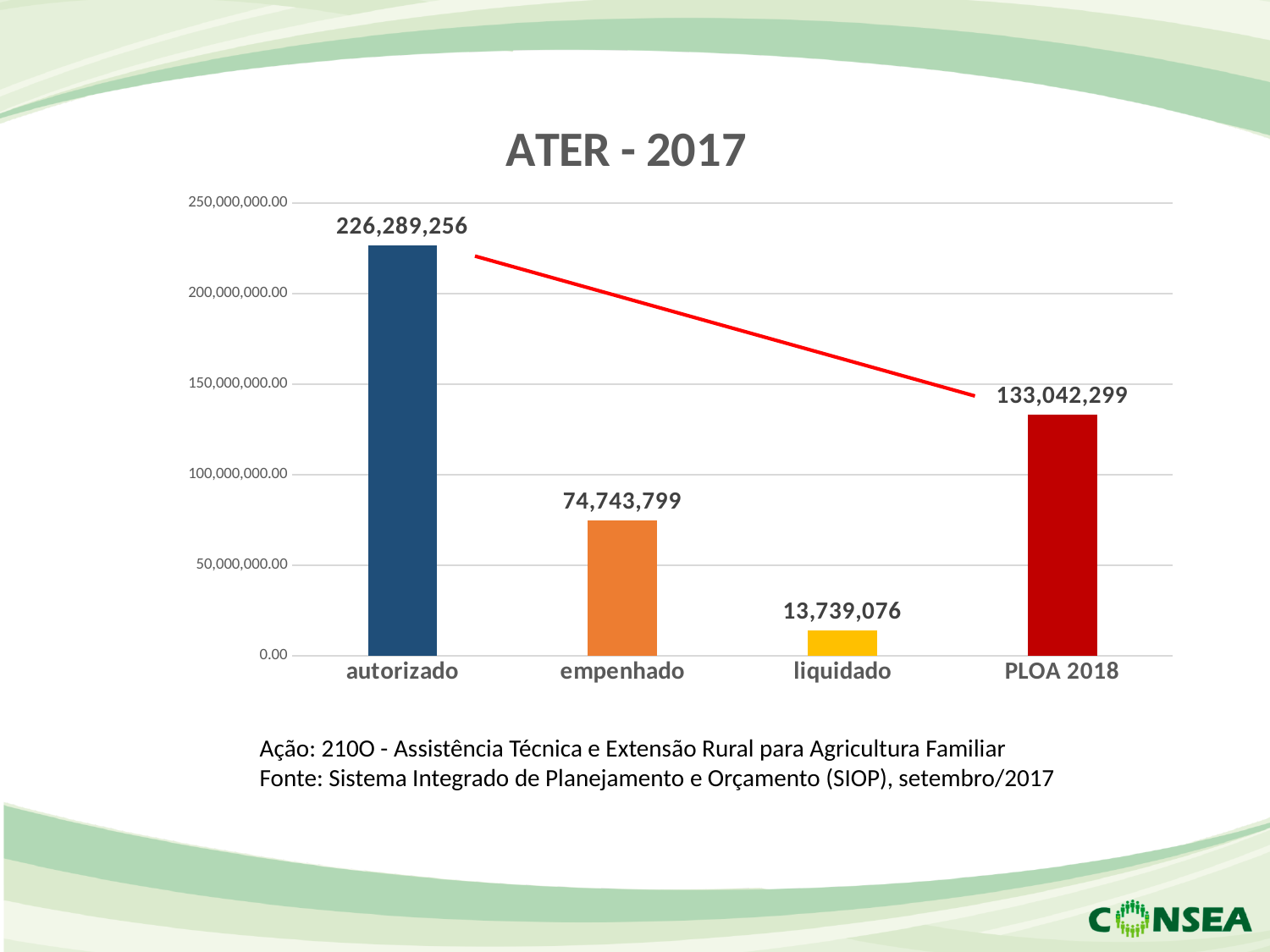
What is the value for PLOA 2018? 133,042,299 What is the difference between the values for empenhado and liquidado? 61,004,723 Which category has the lowest value? liquidado What is the title of the chart? ATER - 2017 What is the value for empenhado? 74,743,799 Which category has the highest value? autorizado How many categories are shown on the x axis? 4 What kind of chart is shown on the slide? bar chart What is the value for autorizado? 226,289,256 What is the value for liquidado? 13,739,076 What is the difference between the values for autorizado and PLOA 2018? 93,246,957 Which is larger, the value for empenhado or the value for PLOA 2018? PLOA 2018